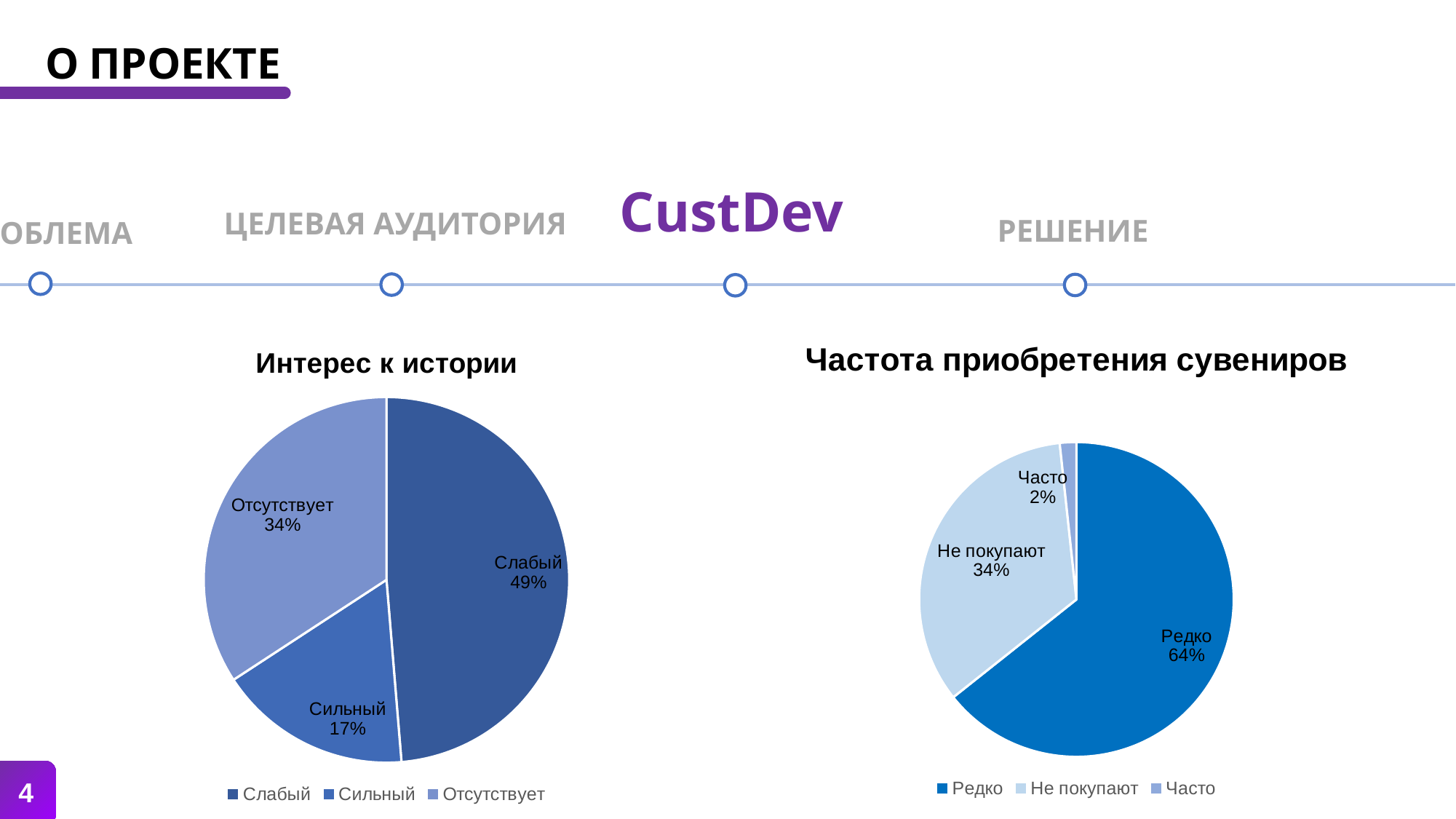
In the "Интерес к истории" chart, what share does "Слабый" have? 49% In the "Частота приобретения сувениров" chart, what share does "Редко" have? 64% In the "Интерес к истории" chart, what is the difference between the "Отсутствует" and "Сильный" shares? 17% How many entries does the legend of the "Частота приобретения сувениров" chart list? 3 In the "Частота приобретения сувениров" chart, which is larger: "Редко" or "Не покупают"? Редко In the "Частота приобретения сувениров" chart, which category has the smallest slice? Часто In the "Частота приобретения сувениров" chart, what share does "Часто" have? 2% In the "Интерес к истории" chart, which category has the largest slice? Слабый In the "Интерес к истории" chart, which category has the smallest slice? Сильный In the "Интерес к истории" chart, how many categories are shown? 3 What type of chart is "Частота приобретения сувениров"? Pie chart In the "Интерес к истории" chart, what share does "Сильный" have? 17%